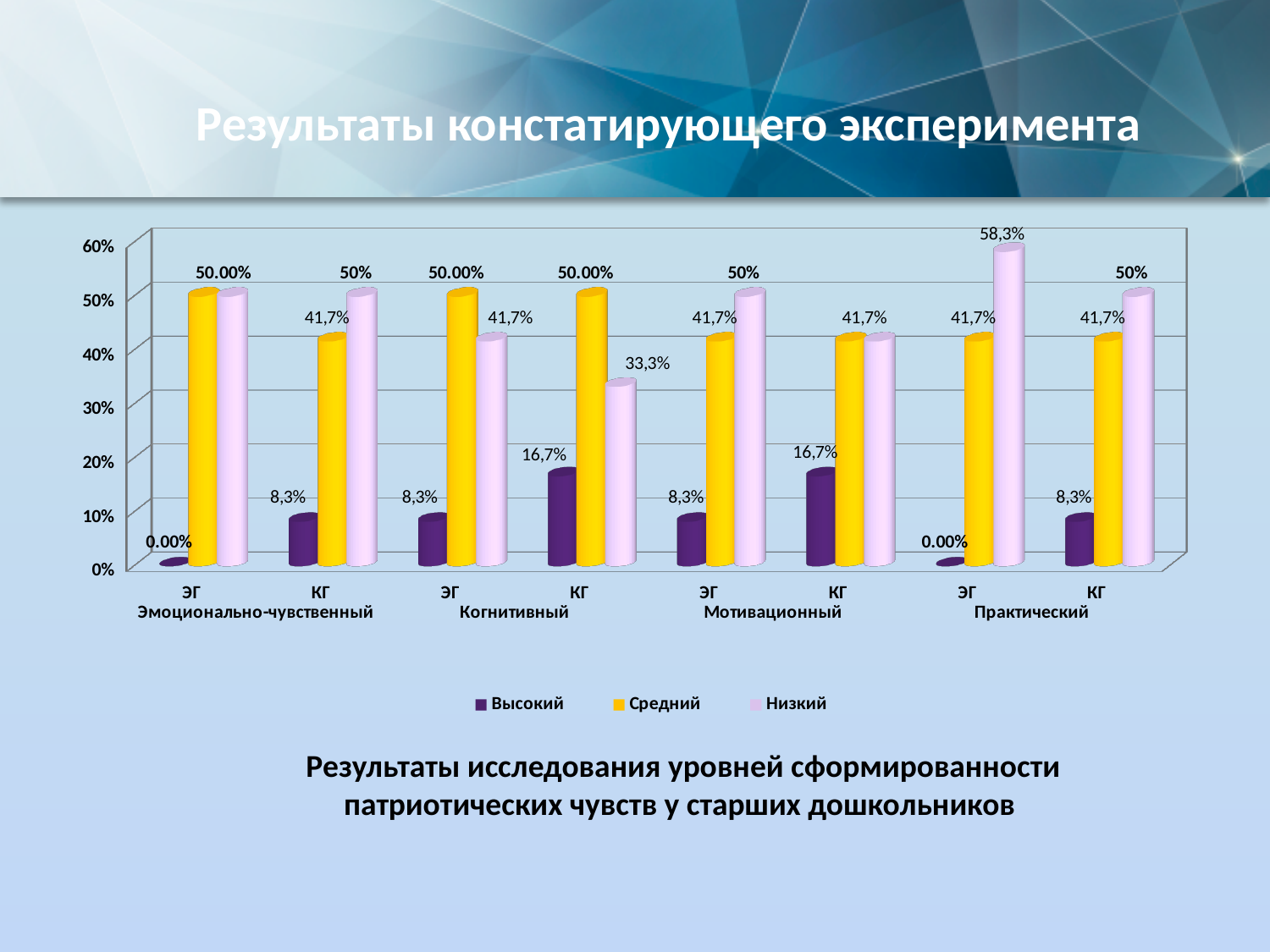
Which group has the lowest Низкий value? КГ Когнитивный How many series does the legend list? 3 Which is larger: the Высокий value for КГ Мотивационный or the Высокий value for ЭГ Мотивационный? КГ Мотивационный What type of chart is shown on the slide? bar chart What is the value of Высокий for ЭГ in the Эмоционально-чувственный component? 0.00% What is the value of Высокий for КГ in the Когнитивный component? 16,7% Which group has the highest Низкий value? ЭГ Практический What is the value of Низкий for КГ in the Когнитивный component? 33,3% What is the value of Низкий for ЭГ in the Практический component? 58,3% How many ЭГ/КГ groups of bars are plotted along the x axis? 8 What is the difference between the Низкий value for ЭГ Практический (58,3%) and the Низкий value for КГ Когнитивный (33,3%)? 25% What are the three series named in the legend? Высокий, Средний, Низкий